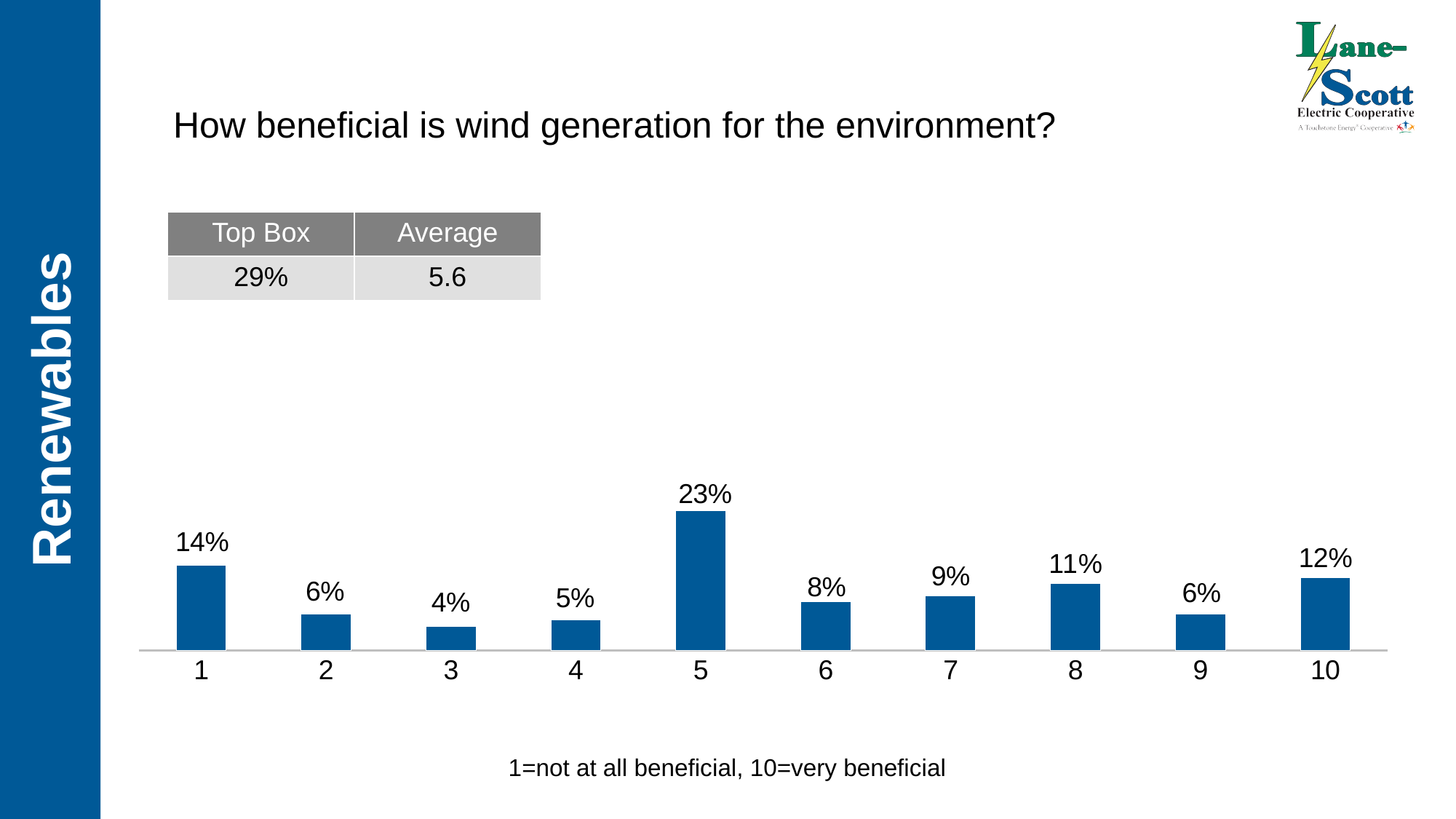
What kind of chart is shown on the slide? Bar chart What percentage of respondents gave a rating of 10? 12% What percentage of respondents gave a rating of 5? 23% What percentage of respondents gave a rating of 8? 11% Which rating received the lowest percentage of responses? 3 How many rating categories are shown on the x axis? 10 What is the difference between the percentage for rating 5 and the percentage for rating 1? 9% Which rating has a larger percentage, 7 or 10? 10 What is the difference between the percentage for rating 8 and the percentage for rating 9? 5% Which rating received the highest percentage of responses? 5 What question does the chart on the slide address? How beneficial is wind generation for the environment? What percentage of respondents gave a rating of 1? 14%